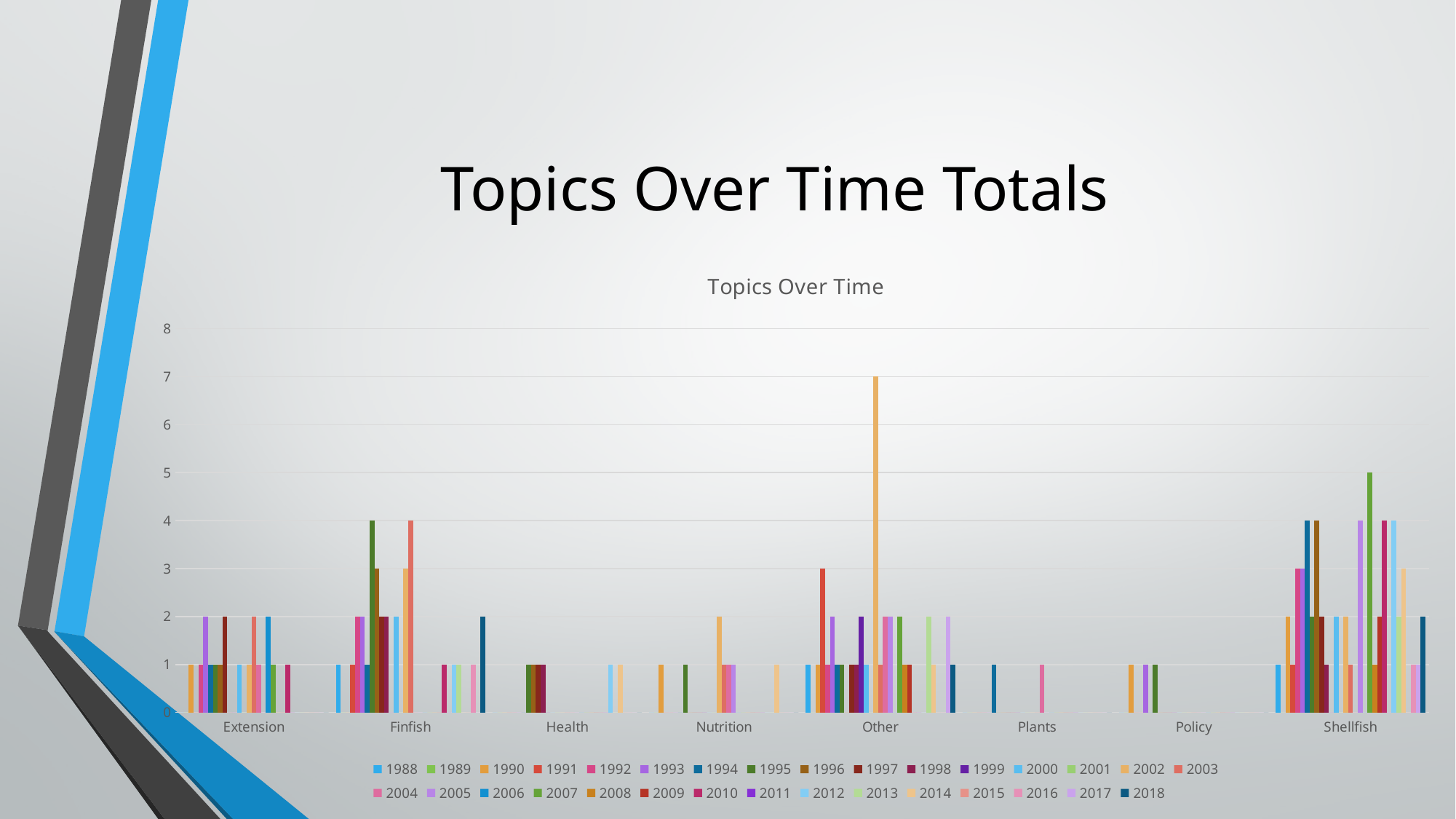
What is the highest value reached by any bar in the Health category? 1 What kind of chart is shown on the slide? bar chart What is the title of the chart? Topics Over Time How many topic categories are shown along the x axis? 8 How many series (years) does the legend list? 31 Which category has the taller maximum bar, Shellfish or Finfish? Shellfish Is the tallest bar in the Finfish category greater or less than 6? less Which category contains the tallest bar in the chart? Other What value does the tallest bar in the Shellfish category reach? 5 What are the first and last years listed in the legend? 1988 and 2018 What value does the tallest bar in the Other category reach? 7 Is the tallest bar in the Other category greater or less than 6? greater